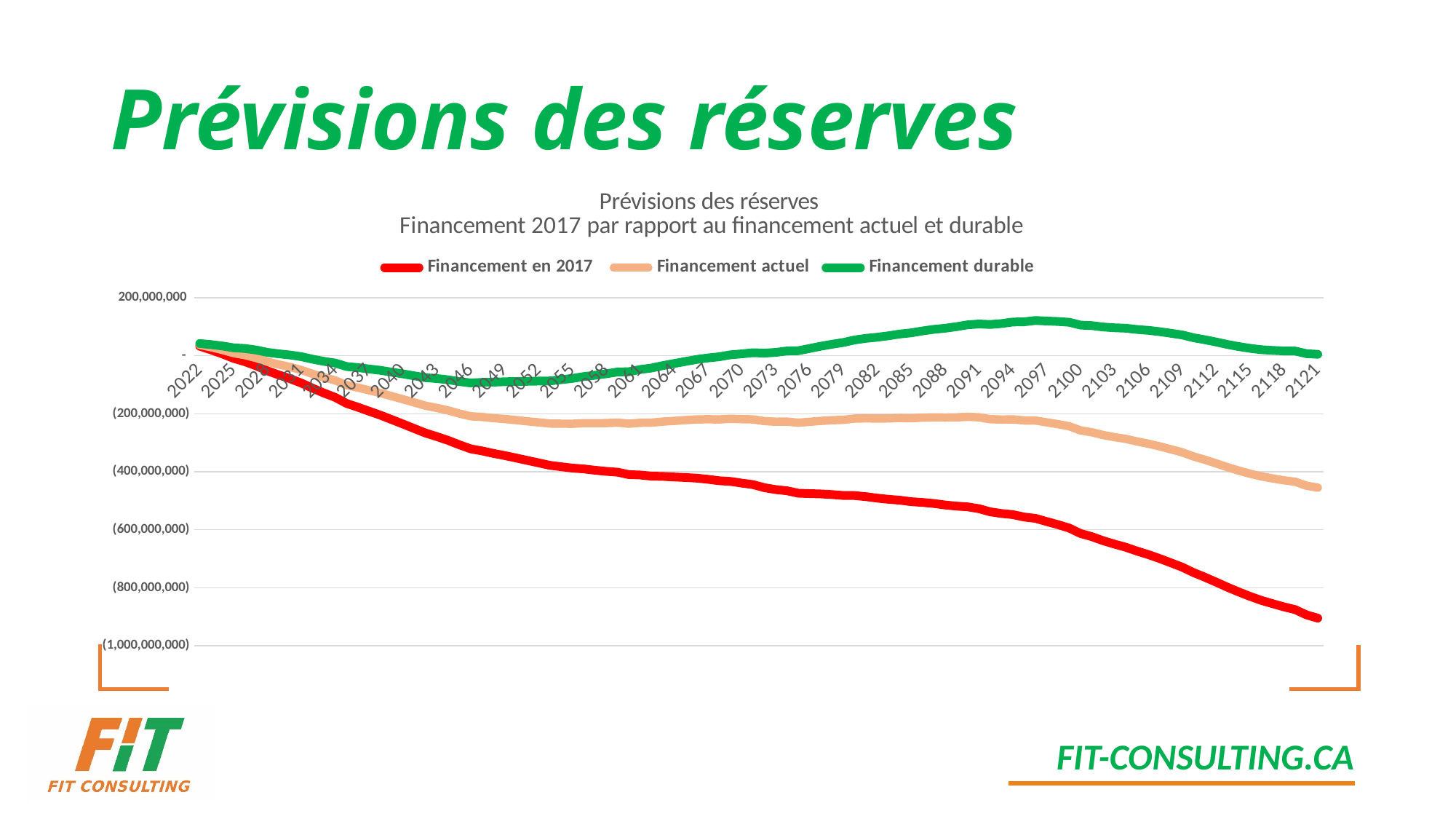
Which series has the lowest value in 2121? Financement en 2017 Is the value for Financement actuel in 2121 greater or less than (400,000,000)? less What are the three series named in the legend? Financement en 2017, Financement actuel, Financement durable Is the value for Financement en 2017 in 2121 greater or less than (800,000,000)? less Which series has the highest value in 2121? Financement durable How many series does the legend list? 3 What is the subtitle line of the chart title below 'Prévisions des réserves'? Financement 2017 par rapport au financement actuel et durable Does the Financement en 2017 series rise or fall from 2022 to 2121? fall In 2049, which is larger: Financement actuel or Financement en 2017? Financement actuel Is the value for Financement durable in 2097 greater or less than 200,000,000? less What kind of chart is shown on the slide? line chart